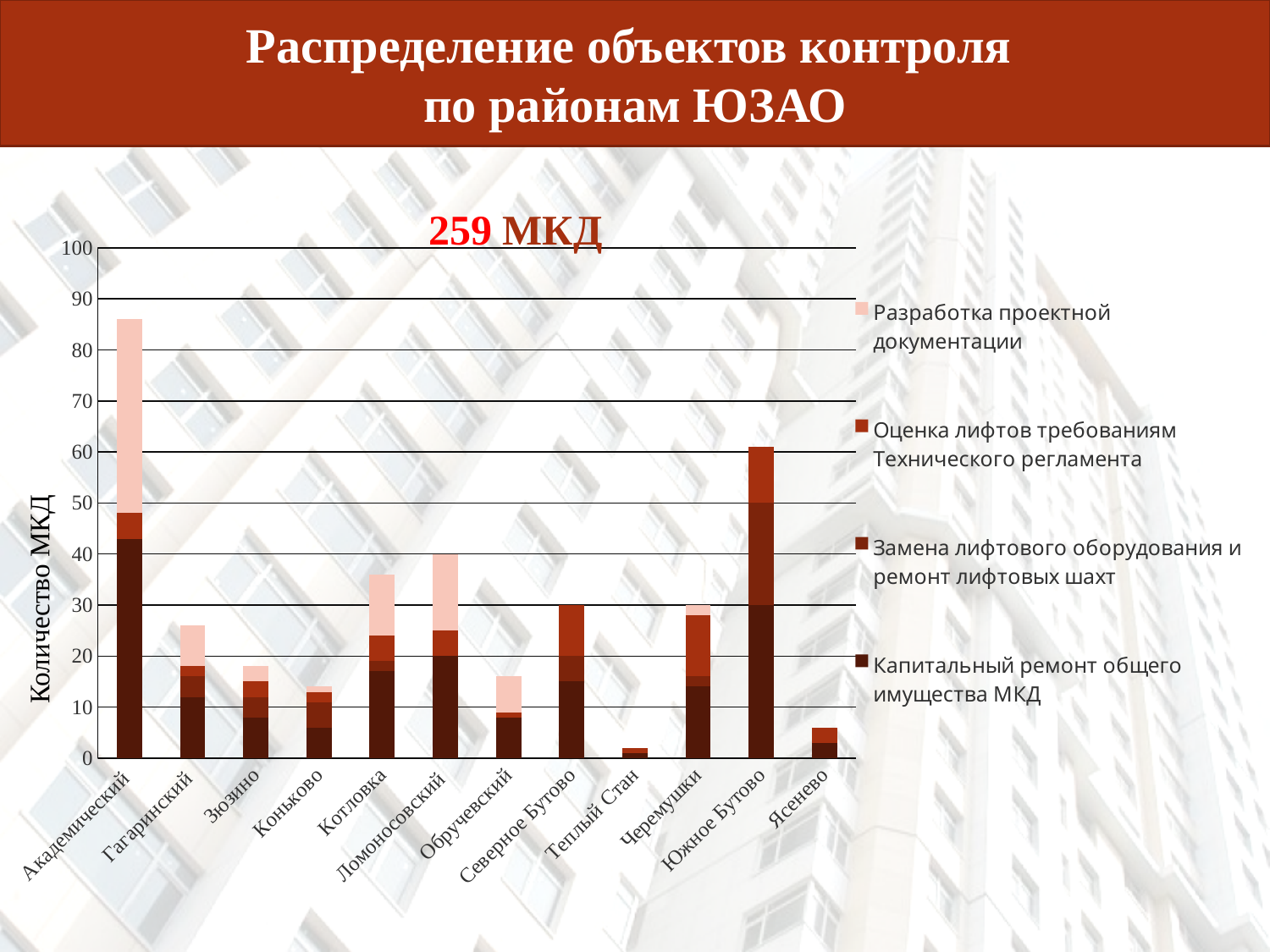
Is the total value for Южное Бутово greater or less than 50? greater Which district has the larger total bar, Академический or Южное Бутово? Академический Is the total value for Ясенево greater or less than 10? less How many series does the legend list? 4 Which district has the tallest stacked bar? Академический What is the label of the vertical axis? Количество МКД How many districts (categories) are shown along the x axis? 12 What kind of chart is shown on the slide? Stacked bar chart Is the total value for Теплый Стан greater or less than 10? less What total number of МКД is stated in the chart title above the plot? 259 МКД Which district has the shortest stacked bar? Теплый Стан